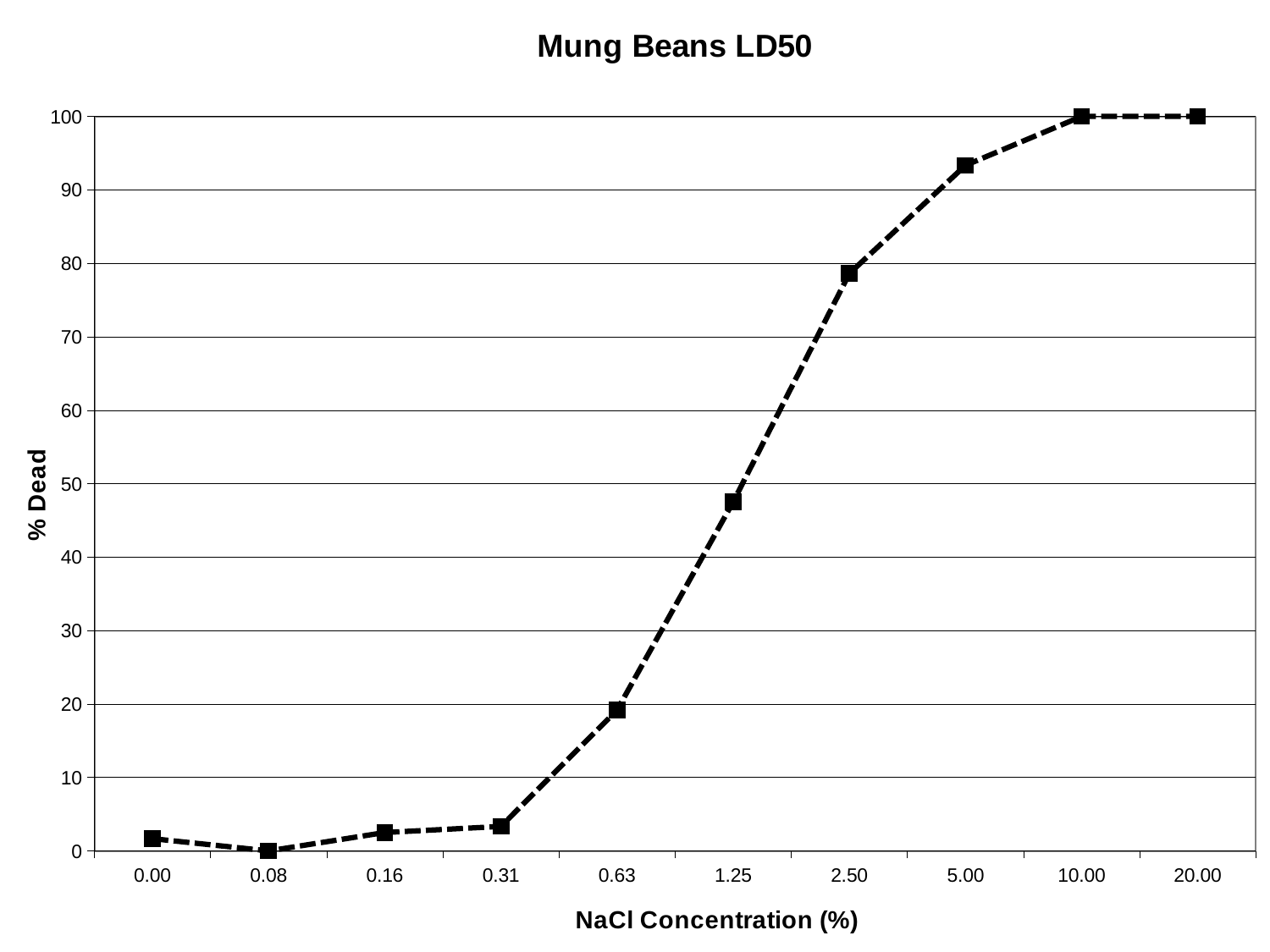
What is the % Dead value at an NaCl concentration of 0.08%? 0 What is the % Dead value at an NaCl concentration of 20.00%? 100 What is the % Dead value at an NaCl concentration of 10.00%? 100 Which has a higher % Dead value, 1.25% NaCl or 2.50% NaCl? 2.50 Is the % Dead value at 2.50% NaCl greater or less than 70? greater Is the % Dead value at 5.00% NaCl greater or less than 90? greater What kind of chart is shown on the slide? line chart What is the label of the y axis? % Dead Which NaCl concentration has the lowest % Dead value? 0.08 Is the % Dead value at 0.63% NaCl greater or less than 30? less What is the title of the chart? Mung Beans LD50 How many data points are plotted on the chart? 10